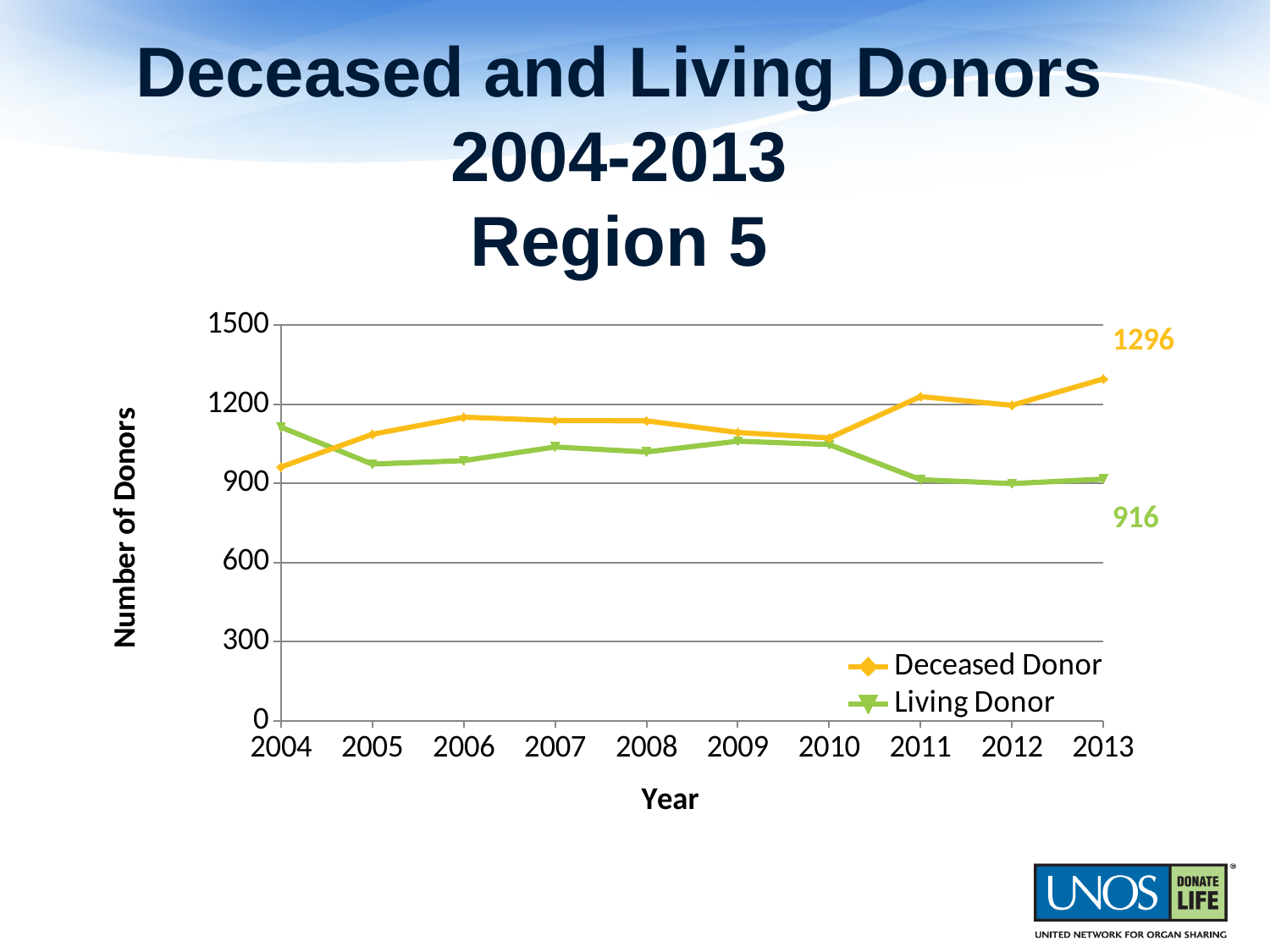
Is the value for Deceased Donor in 2011 greater or less than 900? greater How many series does the legend list? 2 What is the value for Living Donor in 2013? 916 Is the value for Deceased Donor in 2004 greater or less than 1200? less What is the value for Deceased Donor in 2013? 1296 What is the difference between the Deceased Donor and Living Donor values in 2013? 380 In 2013, which series has the larger value, Deceased Donor or Living Donor? Deceased Donor Is the value for Living Donor in 2012 greater or less than 1200? less What kind of chart is shown on the slide? line chart How many years are shown on the x axis? 10 In 2004, which series has the larger value, Deceased Donor or Living Donor? Living Donor Which year has the highest Deceased Donor value? 2013